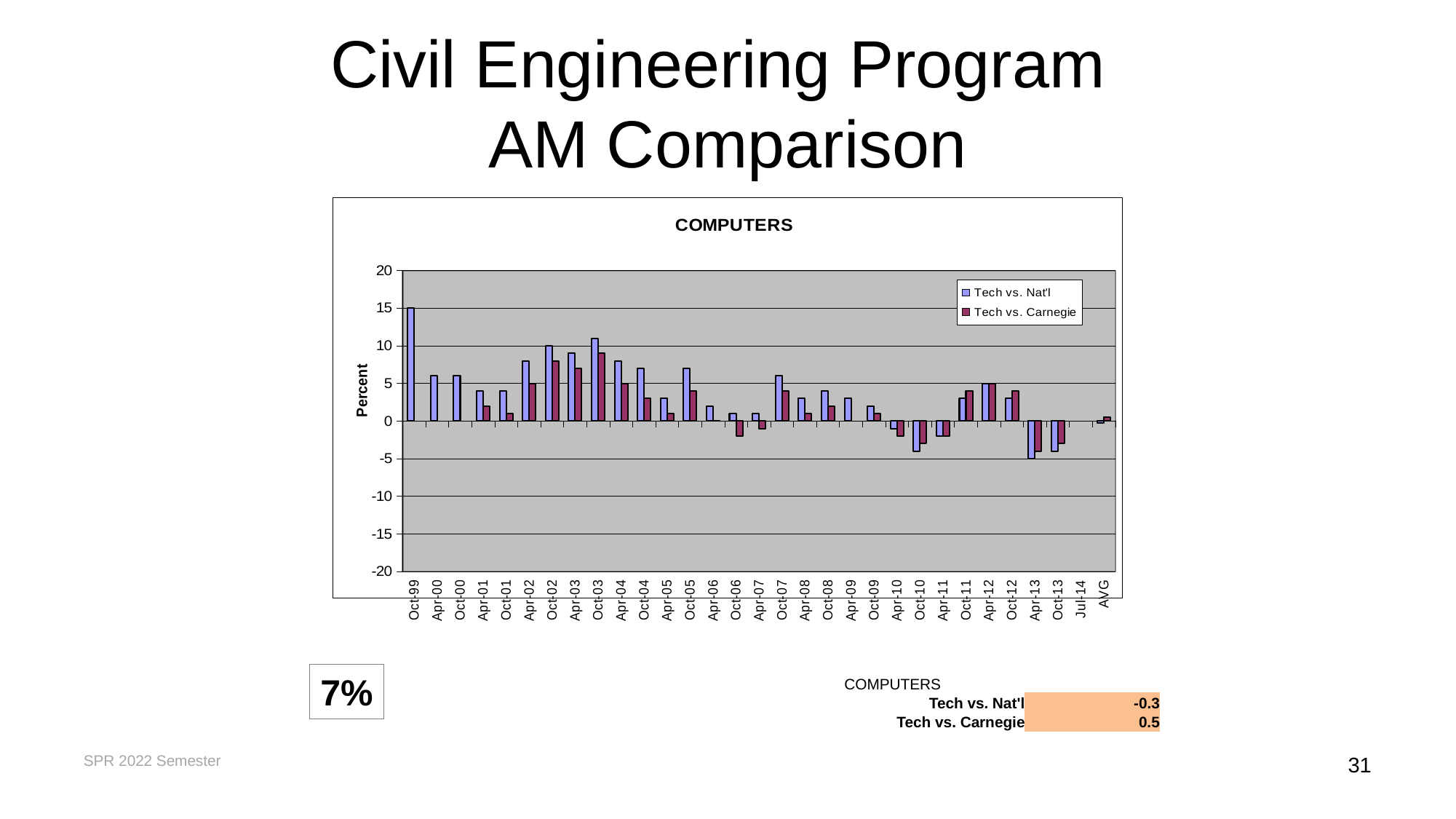
What kind of chart is shown on the slide? bar chart What is the Tech vs. Nat'l value for Oct-02? 10 Is the Tech vs. Nat'l value for Apr-13 greater or less than 0? less Which category has the highest Tech vs. Nat'l value? Oct-99 How many categories are shown along the x axis of the chart? 31 What is the Tech vs. Nat'l value for Oct-99? 15 What is the AVG value for Tech vs. Nat'l shown in the table below the chart? -0.3 What is the label on the vertical axis of the chart? Percent For Apr-02, which is larger: Tech vs. Nat'l or Tech vs. Carnegie? Tech vs. Nat'l What is the AVG value for Tech vs. Carnegie shown in the table below the chart? 0.5 How many series does the legend of the COMPUTERS chart list? 2 What is the title of the chart? COMPUTERS